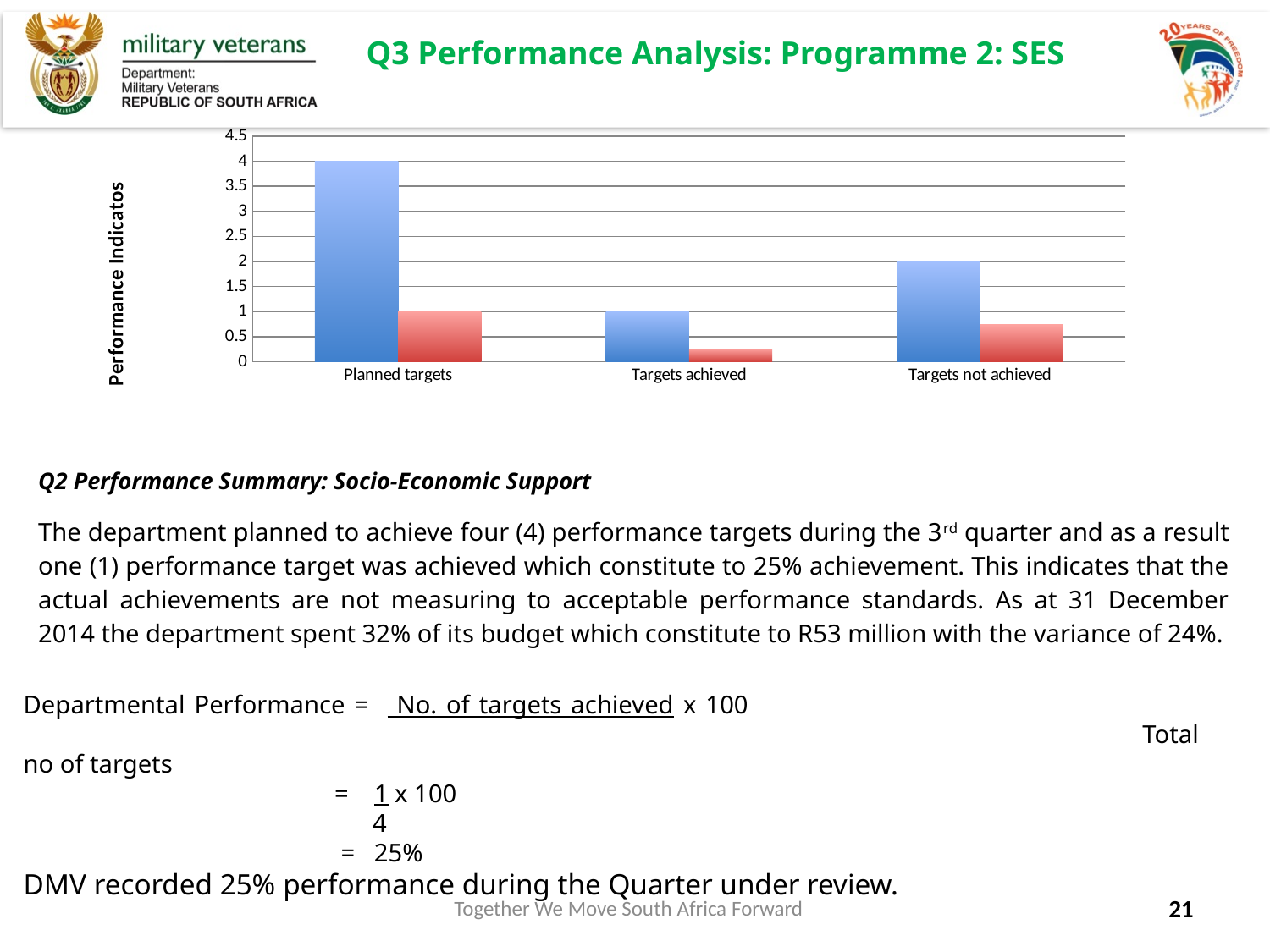
Which has the larger blue bar, Targets achieved or Targets not achieved? Targets not achieved Is the value of the red bar for Targets achieved greater or less than 0.5? less Which category has the tallest blue bar? Planned targets What is the value of the red bar for Planned targets? 1 How many categories are shown on the x axis of the chart? 3 What kind of chart is shown on the slide? Bar chart Which category has the shortest blue bar? Targets achieved What is the value of the blue bar for Planned targets? 4 What is the label on the vertical axis of the chart? Performance Indicatos What is the difference between the blue bar for Planned targets and the blue bar for Targets not achieved? 2 What is the value of the blue bar for Targets not achieved? 2 What is the value of the blue bar for Targets achieved? 1